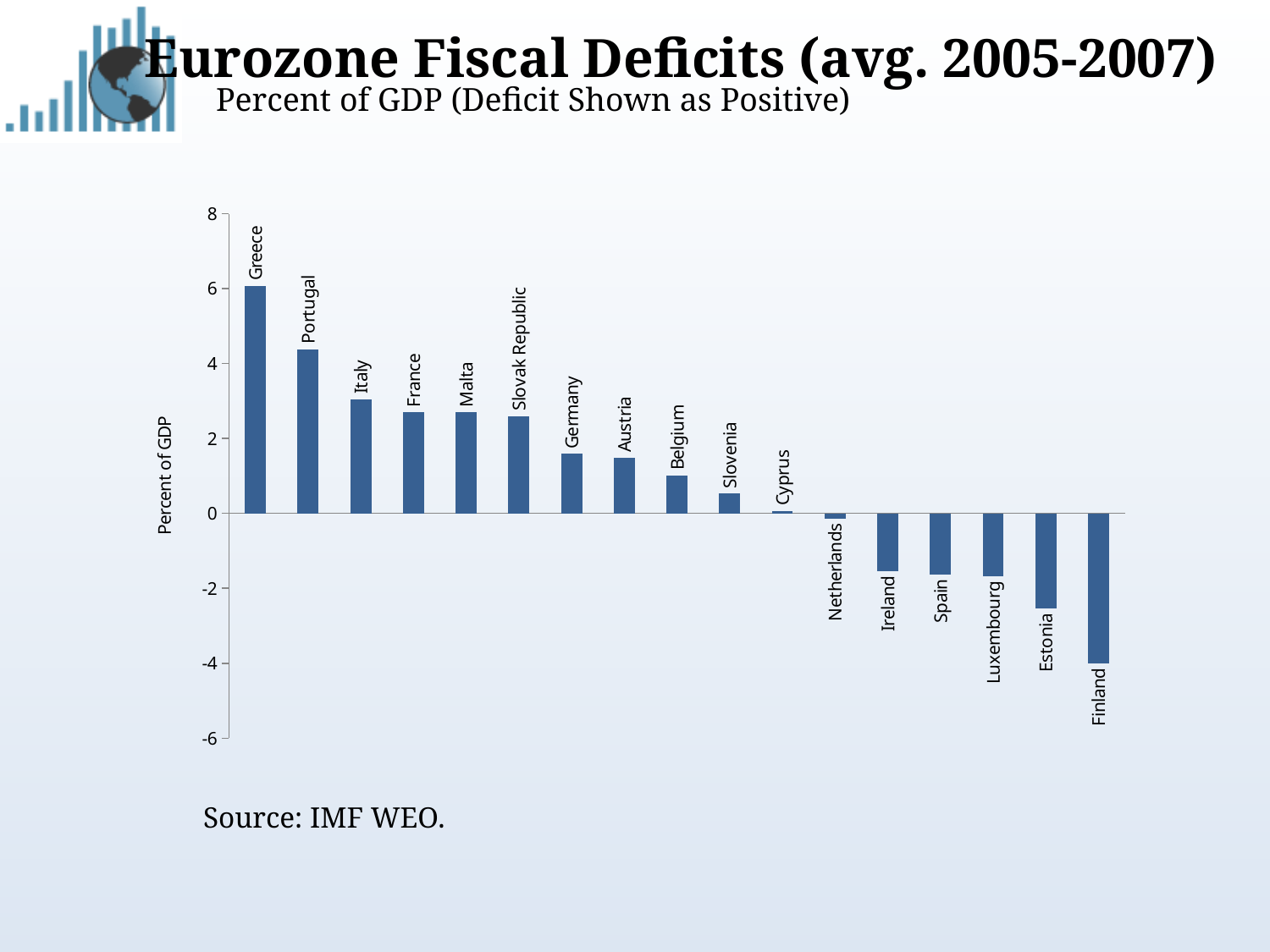
What kind of chart is shown on the slide? Bar chart Is the value for Greece greater or less than 4? greater Is the value for Ireland greater or less than -2? greater Is the value for Italy greater or less than 2? greater Which country has the highest fiscal deficit in the chart? Greece What is the label on the vertical axis of the chart? Percent of GDP Do the values rise or fall moving from left to right along the x axis? Fall Which country has the lowest value in the chart? Finland How many countries are shown in the chart? 17 Which is larger, the value for Greece or the value for Portugal? Greece